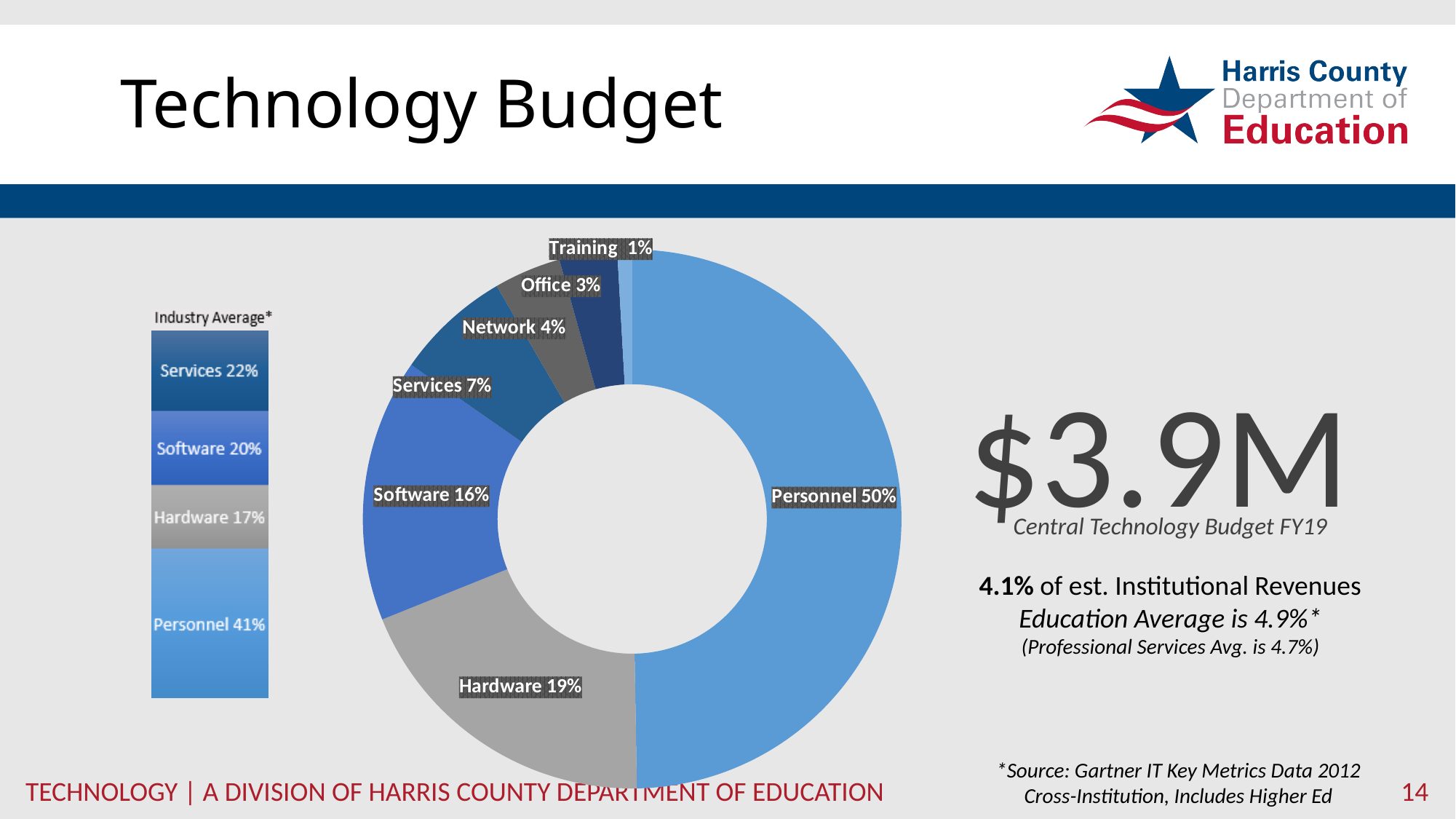
What kind of chart is the chart in the center of the slide? Donut (pie) chart In the donut chart in the center of the slide, how many categories are shown? 7 In the donut chart in the center of the slide, what share of the budget is Hardware? 19% In the donut chart in the center of the slide, what share of the budget is Training? 1% In the donut chart in the center of the slide, what share of the budget is Personnel? 50% In the donut chart in the center of the slide, which category has the smallest share? Training In the Industry Average stacked bar on the left of the slide, what is the value for Personnel? 41% In the Industry Average stacked bar on the left of the slide, what is the value for Services? 22% In the Industry Average stacked bar on the left of the slide, what is the total of all four segments? 100% In the donut chart in the center of the slide, which is larger, Network or Office? Network In the donut chart in the center of the slide, which category has the largest share? Personnel In the donut chart in the center of the slide, what is the difference between the Software share and the Services share? 9%